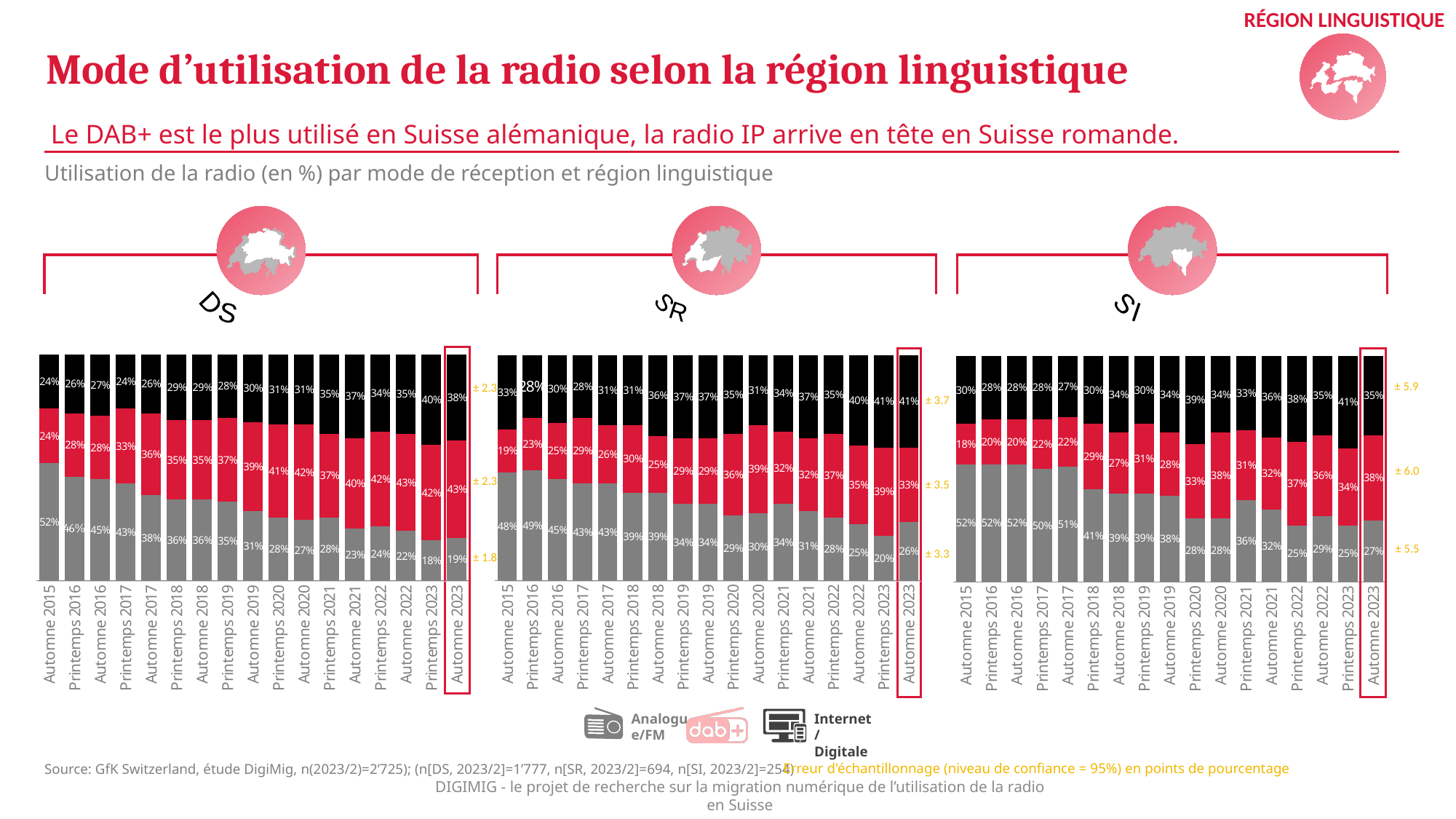
In the DS chart, what is the difference between the Analogue/FM values for Automne 2015 and Automne 2023? 33 percentage points What kind of chart is used for the DS, SR and SI regions? Stacked bar chart In the SI chart, does the Analogue/FM value rise or fall from Automne 2015 to Automne 2023? Fall In the SR chart, which is larger for Automne 2023: the DAB+ value or the Internet/Digitale value? Internet/Digitale In the SR chart, what is the Internet/Digitale value for Automne 2023? 41% In the DS chart, what is the DAB+ value for Automne 2023? 43% In the DS chart, which period has the lowest Analogue/FM value? Printemps 2023 In the SI chart, what is the Analogue/FM value for Automne 2023? 27% How many periods are shown on the x axis of the DS chart? 17 In the SI chart, what is the DAB+ value for Automne 2015? 18% How many series does the legend list? 3 In the DS chart, what is the Analogue/FM value for Automne 2015? 52%